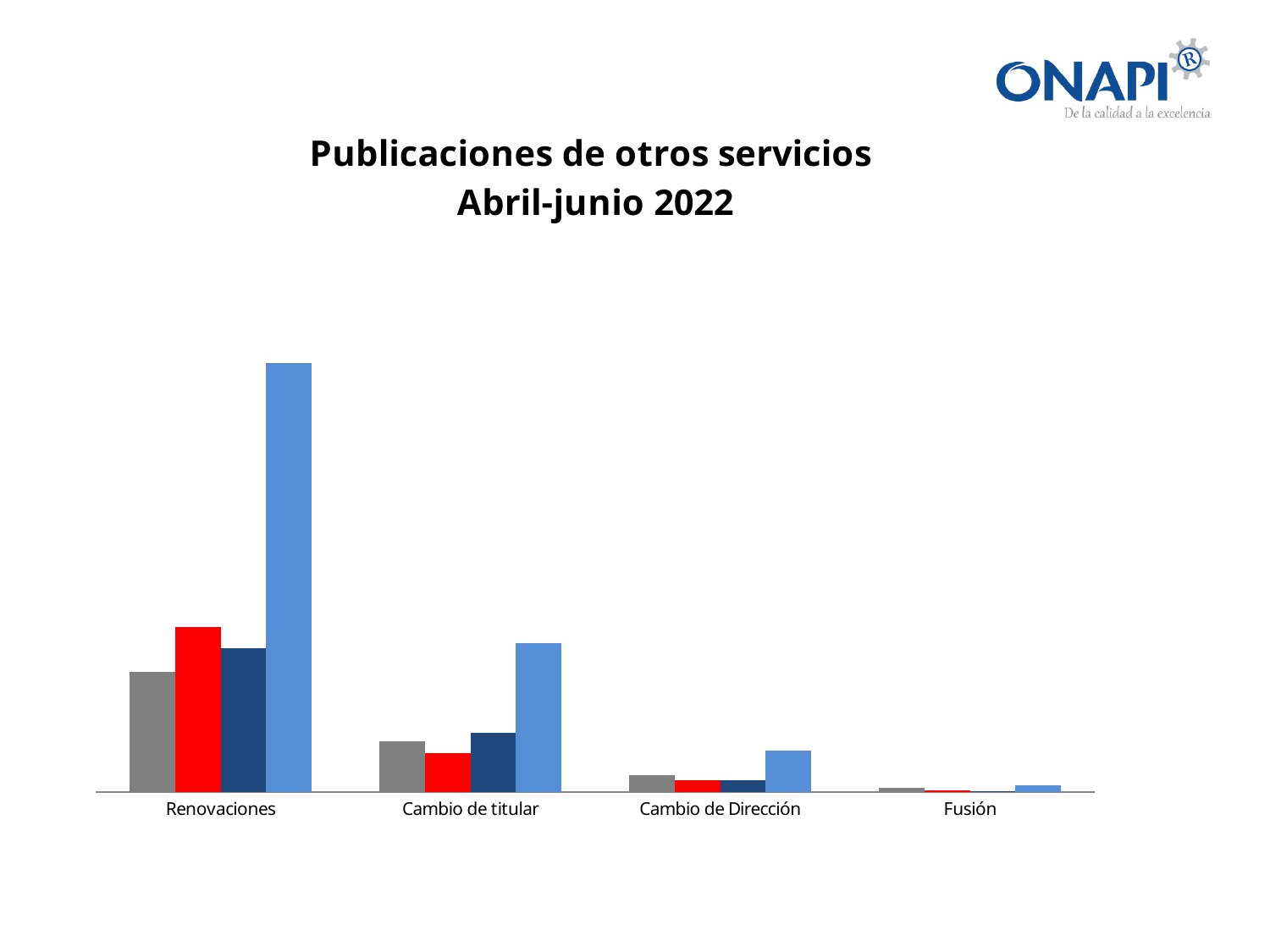
Do the light blue bars rise or fall moving from Renovaciones to Fusión along the x axis? fall Which category has the tallest bar in the chart? Renovaciones Which category has the shortest bars in the chart? Fusión What is the title of the chart? Publicaciones de otros servicios Abril-junio 2022 Is the light blue bar for Cambio de titular taller or shorter than the light blue bar for Renovaciones? shorter Within the Cambio de titular category, is the gray bar taller or shorter than the red bar? taller How many categories are shown on the x axis of the chart? 4 Within the Renovaciones category, which coloured bar is the tallest? light blue Within the Renovaciones category, is the red bar taller or shorter than the gray bar? taller How many bars are shown for each category in the chart? 4 What kind of chart is shown on the slide? bar chart